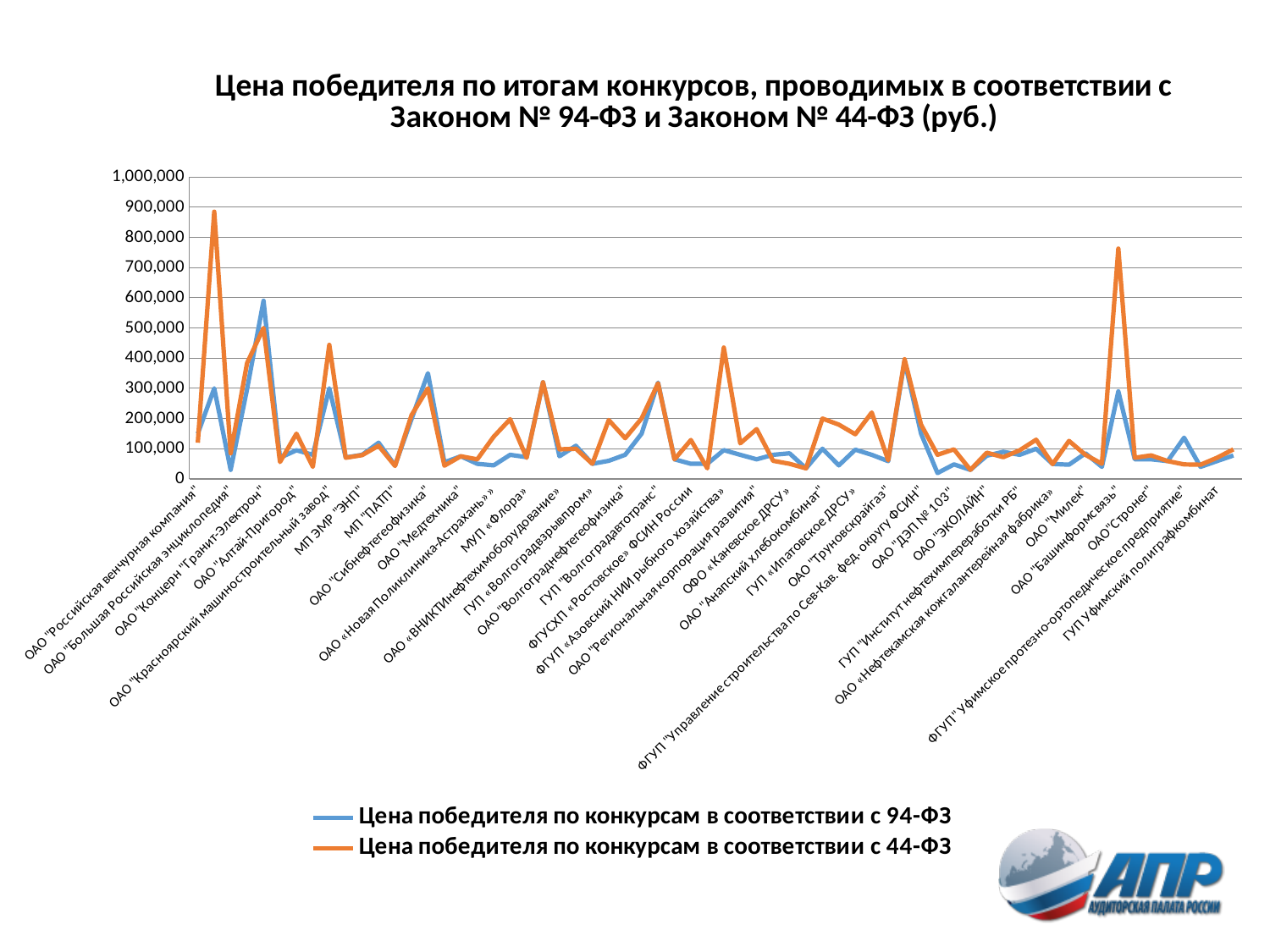
Is the highest value on the chart greater or less than 1,000,000? less Is the highest value of the series 'Цена победителя по конкурсам в соответствии с 44-ФЗ' greater or less than 800,000? greater What is the title of the chart? Цена победителя по итогам конкурсов, проводимых в соответствии с Законом № 94-ФЗ и Законом № 44-ФЗ (руб.) What is the maximum value shown on the vertical axis? 1,000,000 How many series does the legend list? 2 Which series reaches the higher maximum value on the chart, 94-ФЗ or 44-ФЗ? 44-ФЗ Is the highest value of the series 'Цена победителя по конкурсам в соответствии с 94-ФЗ' greater or less than 700,000? less What kind of chart is shown on the slide? line chart Which series is drawn in orange according to the legend? Цена победителя по конкурсам в соответствии с 44-ФЗ